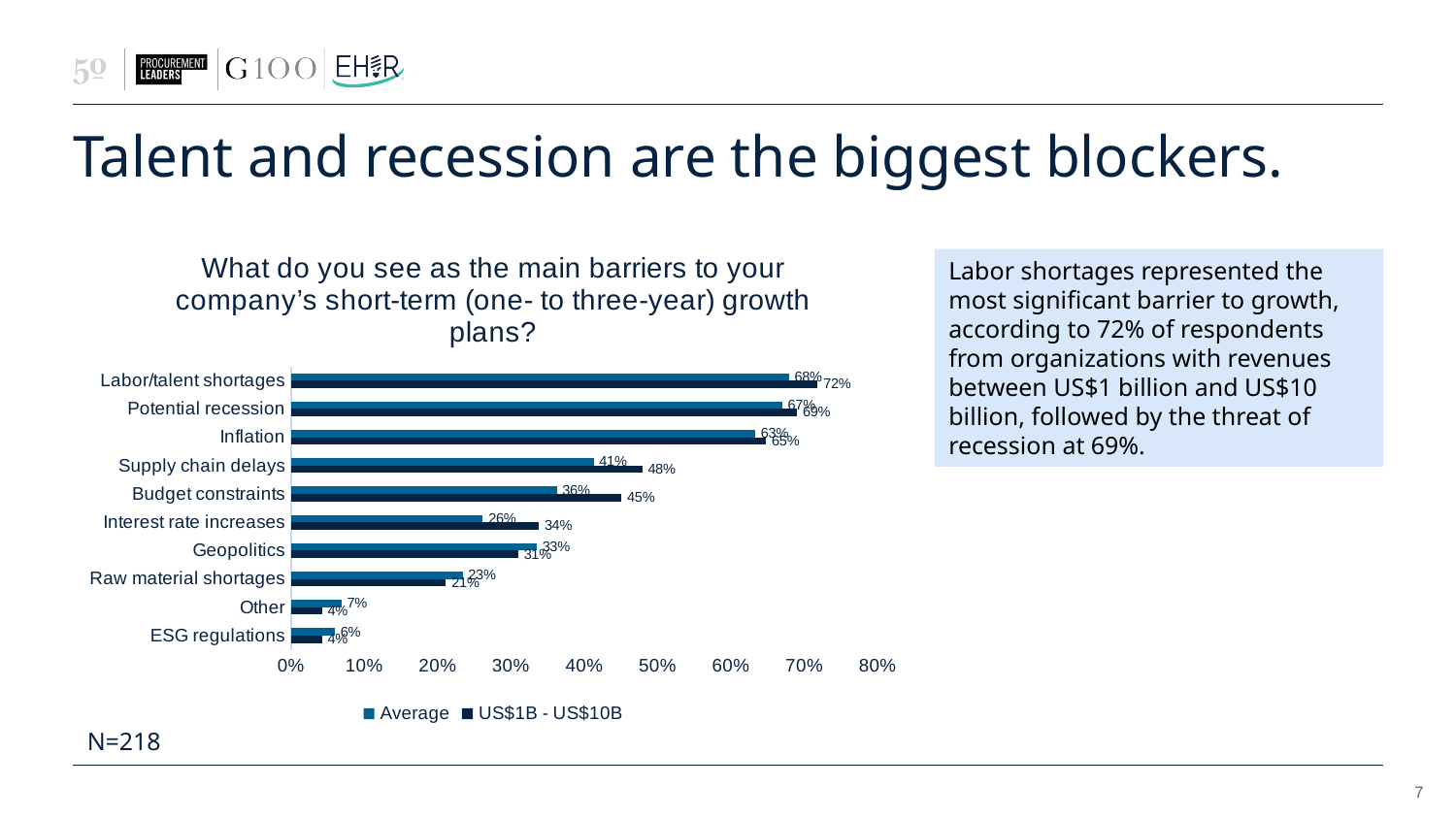
What is the Average value for Budget constraints? 36% What is the US$1B - US$10B value for Labor/talent shortages? 72% Which category has the lowest Average value? ESG regulations What is the US$1B - US$10B value for Supply chain delays? 48% For Interest rate increases, which is larger: the Average value or the US$1B - US$10B value? US$1B - US$10B What is the difference between the US$1B - US$10B and Average values for Budget constraints? 9% What kind of chart is shown on the slide? Bar chart Which category has the highest US$1B - US$10B value? Labor/talent shortages How many series does the legend list? 2 How many barrier categories are plotted on the chart? 10 What is the Average value for Labor/talent shortages? 68% What is the sample size (N) shown on the slide? N=218